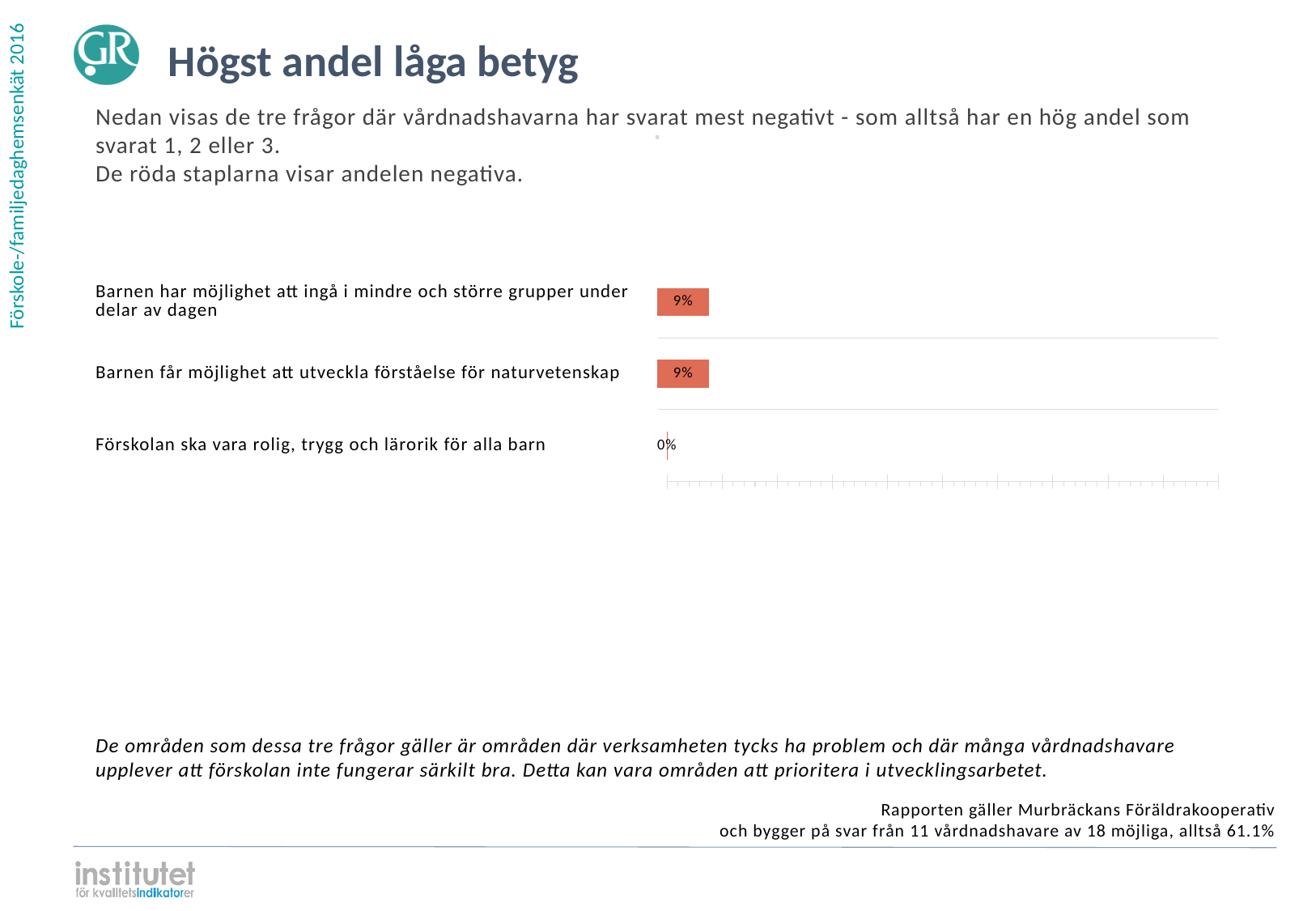
What is the value for "Barnen får möjlighet att utveckla förståelse för naturvetenskap"? 9% How many categories have a value of 9%? 2 What is the value for "Förskolan ska vara rolig, trygg och lärorik för alla barn"? 0% How many categories are shown in the chart? 3 Which category has the lowest value? Förskolan ska vara rolig, trygg och lärorik för alla barn What colour are the bars in the chart? Red What is the value for "Barnen har möjlighet att ingå i mindre och större grupper under delar av dagen"? 9% What is the difference between the value for "Barnen får möjlighet att utveckla förståelse för naturvetenskap" and the value for "Förskolan ska vara rolig, trygg och lärorik för alla barn"? 9% What is the title of the slide containing the chart? Högst andel låga betyg What kind of chart is shown on the slide? Bar chart What is the difference between the values for "Barnen har möjlighet att ingå i mindre och större grupper under delar av dagen" and "Barnen får möjlighet att utveckla förståelse för naturvetenskap"? 0% Which is larger: the value for "Barnen har möjlighet att ingå i mindre och större grupper under delar av dagen" or the value for "Förskolan ska vara rolig, trygg och lärorik för alla barn"? Barnen har möjlighet att ingå i mindre och större grupper under delar av dagen